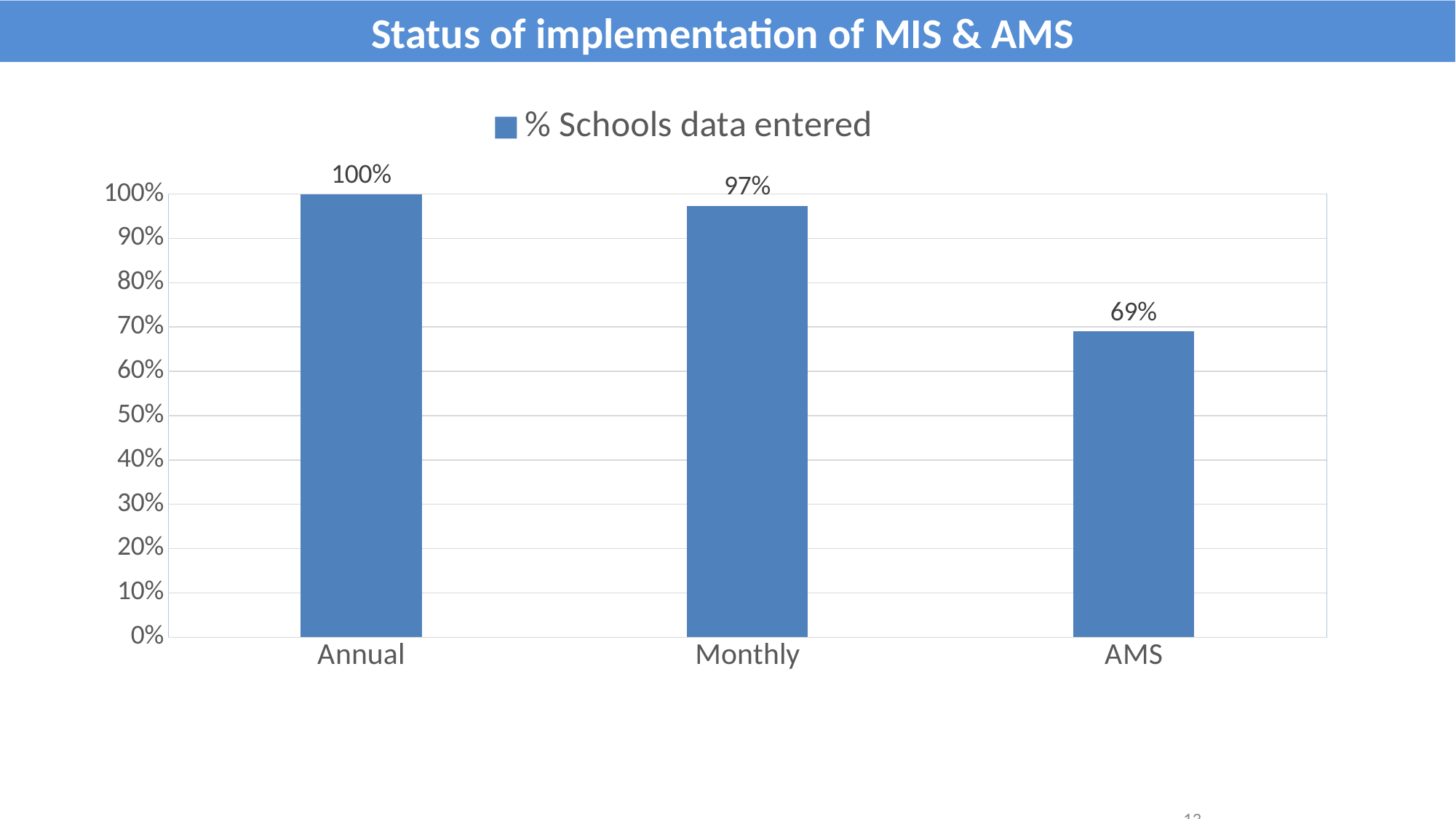
What is the value for Monthly? 97% Which category has the lowest value? AMS What is the legend entry for the series shown? % Schools data entered What is the value for Annual? 100% Which is larger, the value for Monthly or the value for AMS? Monthly How many categories are shown on the x axis? 3 What is the difference between the values for Monthly and AMS? 28% Which category has the highest value? Annual What kind of chart is shown on the slide? bar chart What is the difference between the values for Annual and Monthly? 3% What is the value for AMS? 69% Is the value for AMS greater or less than 80%? less